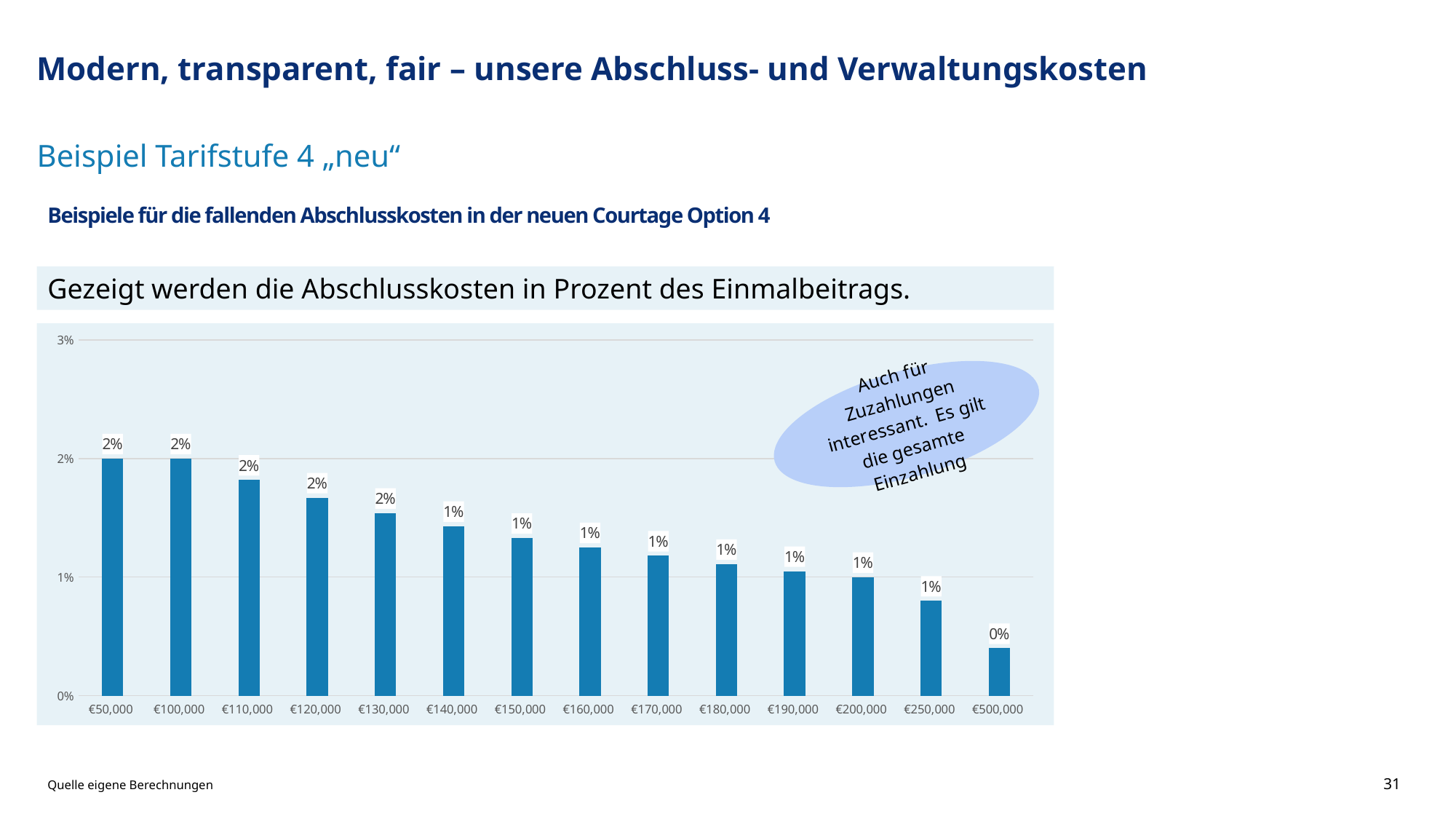
Do the bar values rise or fall as the Einmalbeitrag increases along the x axis? fall What is the highest tick value shown on the y axis of the chart? 3% What is the data label shown for €130,000? 2% What kind of chart is shown on the slide? bar chart What is the data label shown for €500,000? 0% Which bar is taller, €50,000 or €250,000? €50,000 Is the value for €110,000 greater or less than 2%? less What is the data label shown for €50,000? 2% What is the data label shown for €150,000? 1% Which category has the lowest bar in the chart? €500,000 Is the value for €500,000 greater or less than 1%? less How many categories (Einmalbeitrag amounts) are shown on the x axis of the chart? 14